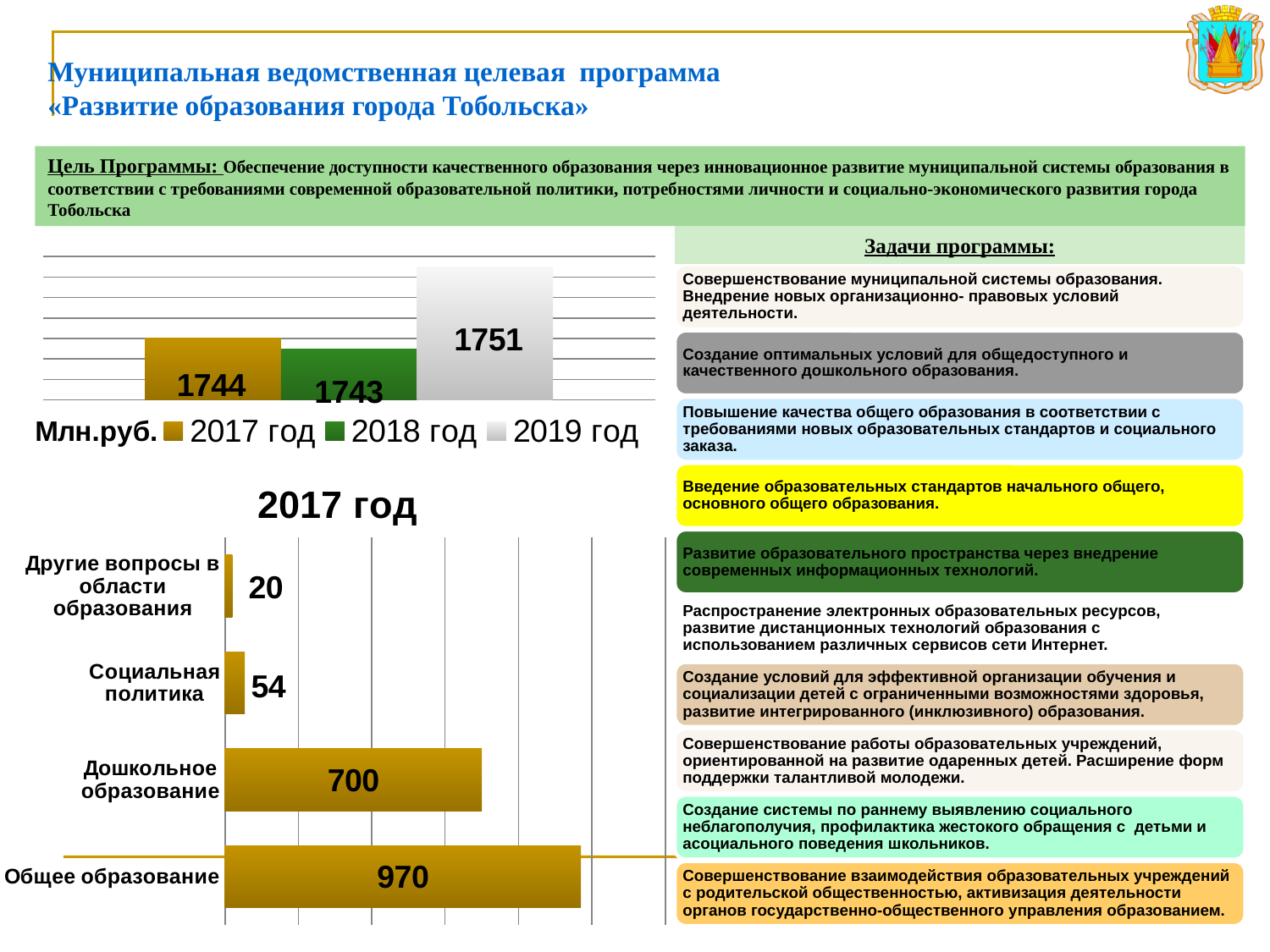
In the top chart (legend 'Млн.руб.'), what is the value for 2019 год? 1751 In the chart titled '2017 год', what is the value for Социальная политика? 54 In the top chart (legend 'Млн.руб.'), which year has the highest value? 2019 год In the top chart (legend 'Млн.руб.'), how many series does the legend list? 3 In the top chart (legend 'Млн.руб.'), what is the difference between the 2019 год and 2018 год values? 8 In the chart titled '2017 год', what is the difference between Общее образование and Дошкольное образование? 270 In the chart titled '2017 год', which category has the highest value? Общее образование In the chart titled '2017 год', which category has the lowest value? Другие вопросы в области образования In the top chart (legend 'Млн.руб.'), what colour is the bar for 2018 год? Green In the chart titled '2017 год', what is the value for Дошкольное образование? 700 In the chart titled '2017 год', how many categories are shown? 4 In the top chart (legend 'Млн.руб.'), what is the value for 2017 год? 1744